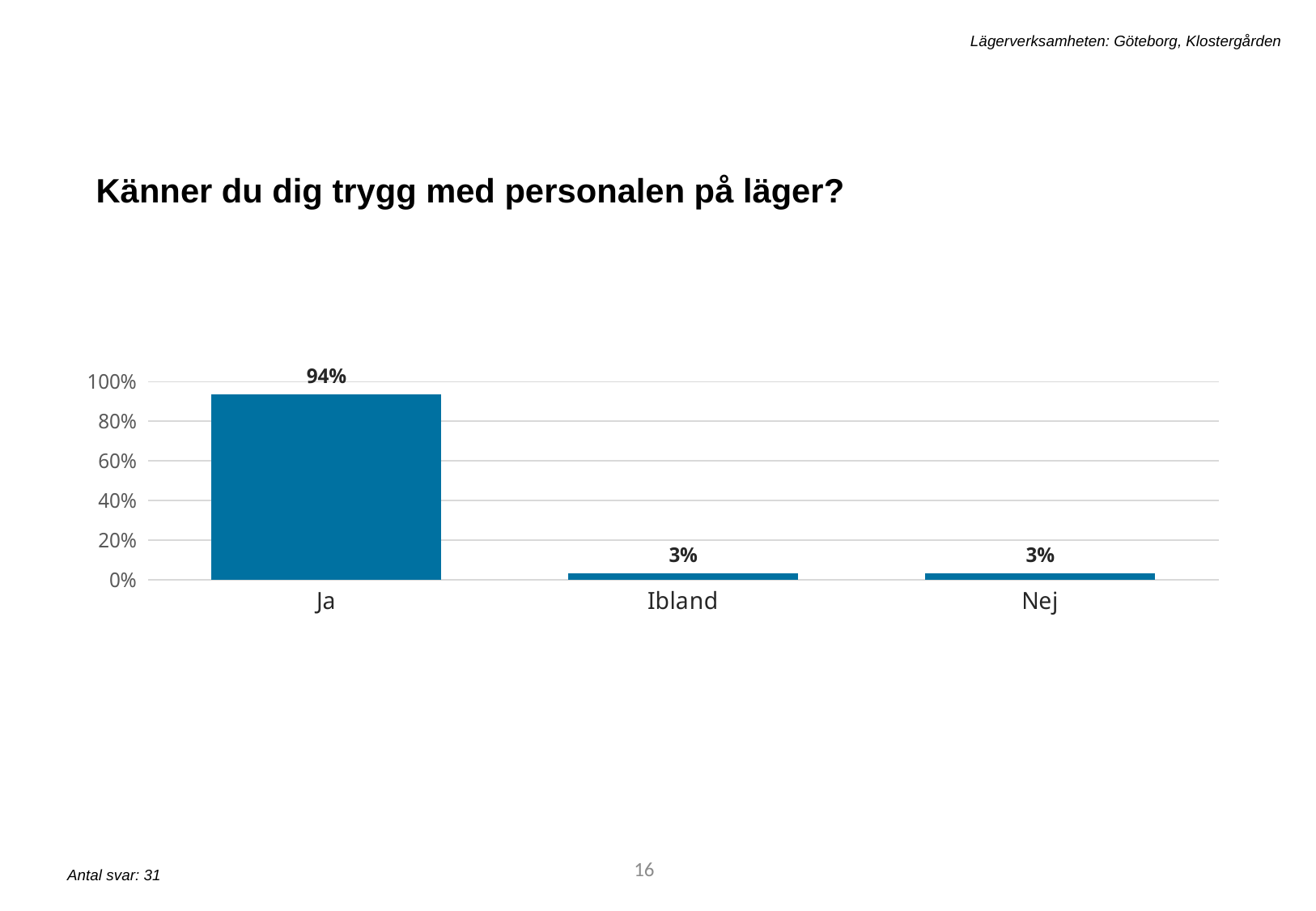
Which is larger, the value for Ja or the value for Nej? Ja What is the title of the chart? Känner du dig trygg med personalen på läger? How many categories are shown on the x axis? 3 What is the difference between the values for Ja and Ibland? 91% What kind of chart is shown on the slide? bar chart Is the value for Ja greater or less than 80%? greater What is the value for Ja? 94% Is the value for Ibland greater or less than 20%? less What is the value for Ibland? 3% Which category has the highest value? Ja What is the highest value shown on the y axis? 100% What is the value for Nej? 3%